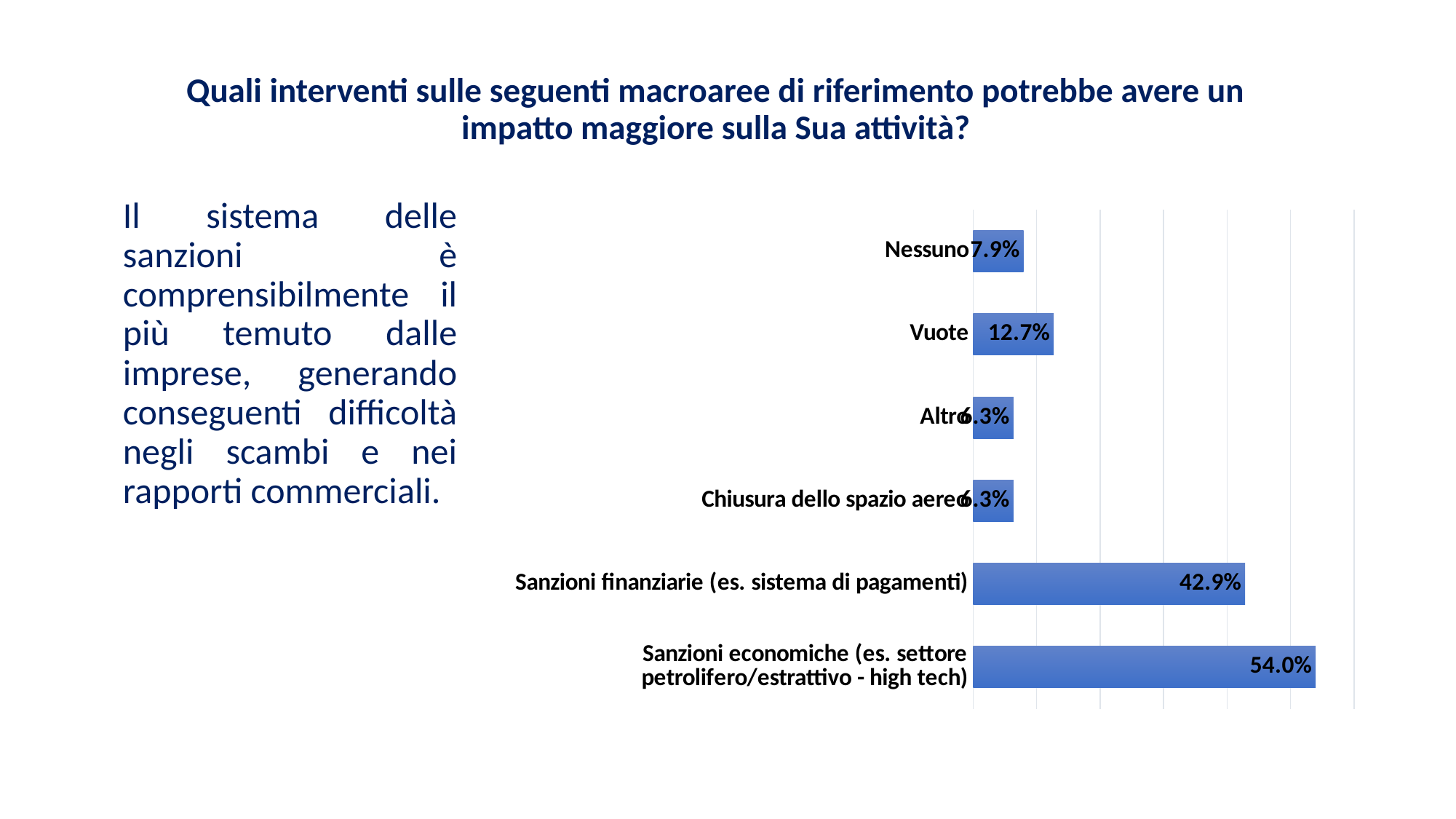
What is the value for "Chiusura dello spazio aereo"? 6.3% Which is larger, the value for "Vuote" or the value for "Nessuno"? Vuote Which two categories share the same value of 6.3%? Altro and Chiusura dello spazio aereo What is the value for "Nessuno"? 7.9% What is the difference between the values for "Sanzioni economiche (es. settore petrolifero/estrattivo - high tech)" and "Sanzioni finanziarie (es. sistema di pagamenti)"? 11.1% What is the difference between the values for "Vuote" and "Altro"? 6.4% What is the value for "Sanzioni finanziarie (es. sistema di pagamenti)"? 42.9% What is the value for "Sanzioni economiche (es. settore petrolifero/estrattivo - high tech)"? 54.0% What kind of chart is shown on the slide? bar chart Which category has the highest value? Sanzioni economiche (es. settore petrolifero/estrattivo - high tech) What is the value for "Vuote"? 12.7% How many categories are shown in the chart? 6